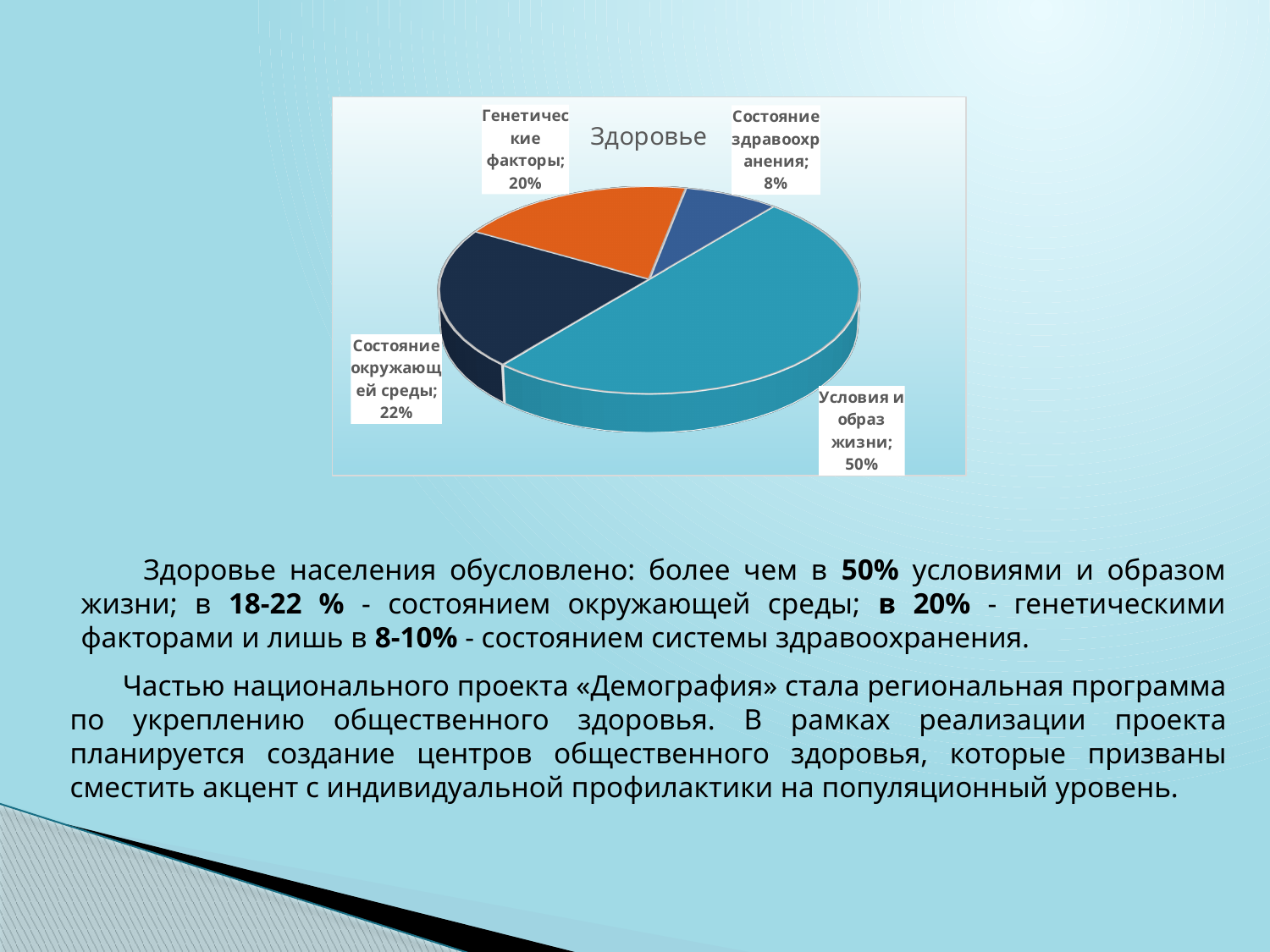
Which is larger: the share for "Состояние окружающей среды" or the share for "Состояние здравоохранения"? Состояние окружающей среды What share of the pie is labelled "Состояние окружающей среды"? 22% What share of the pie is labelled "Состояние здравоохранения"? 8% What colour is the slice for "Генетические факторы"? orange What share of the pie is labelled "Генетические факторы"? 20% What is the title of the chart? Здоровье What share of the pie is labelled "Условия и образ жизни"? 50% Which slice of the pie is the smallest? Состояние здравоохранения How many slices does the pie chart have? 4 What is the difference between the shares for "Условия и образ жизни" and "Генетические факторы"? 30% Which slice of the pie is the largest? Условия и образ жизни What kind of chart is shown on the slide? pie chart